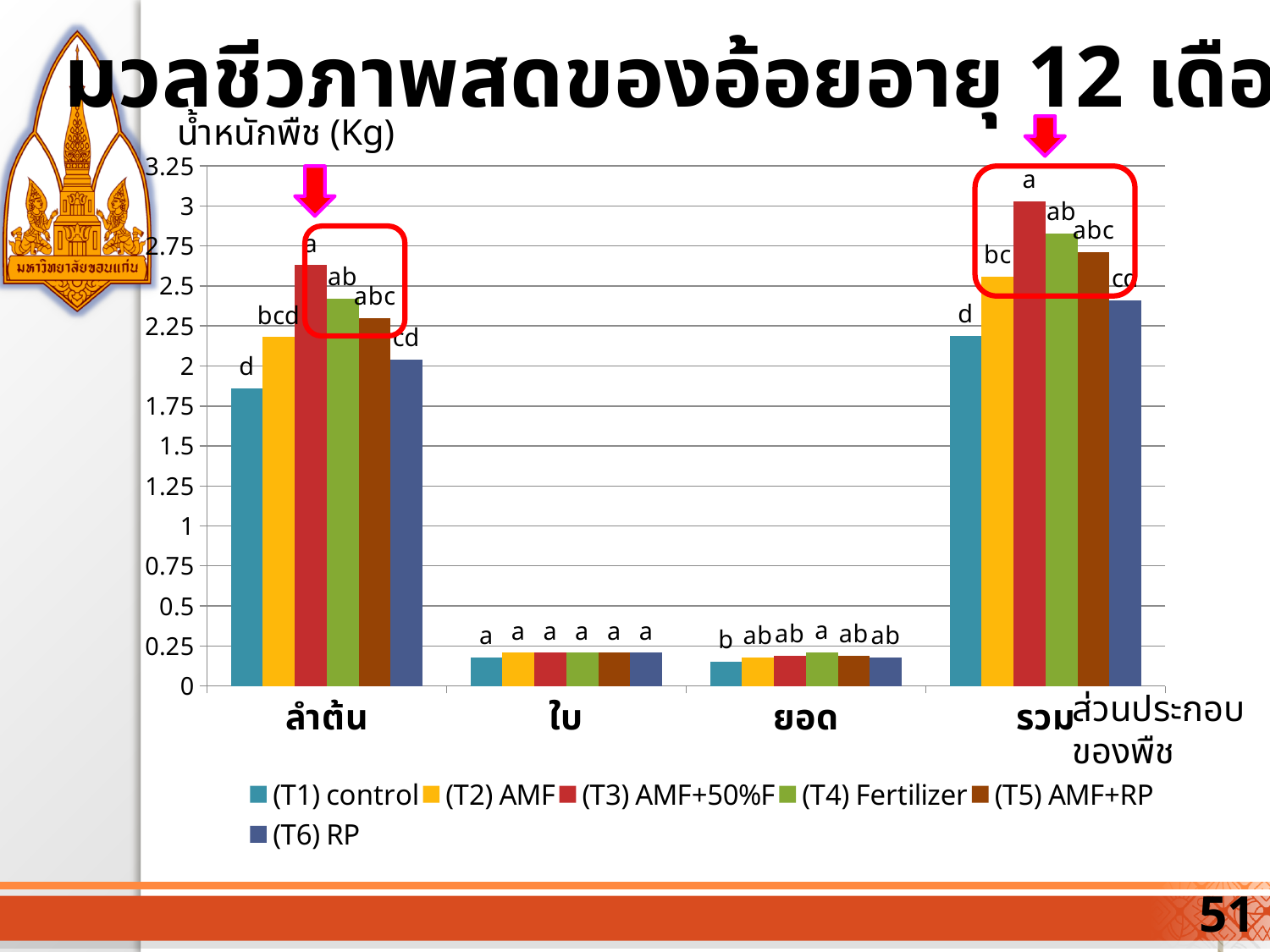
What kind of chart is shown on the slide? bar chart In the รวม category, which is larger: the value for (T3) AMF+50%F or the value for (T6) RP? (T3) AMF+50%F What is the label of the chart's vertical axis? น้ำหนักพืช (Kg) In the ลำต้น category, which series has the highest bar? (T3) AMF+50%F Is the value for (T1) control in the รวม category greater or less than 2.5? less Is the value for (T1) control in the ลำต้น category greater or less than 2? less In the รวม category, which series has the lowest bar? (T1) control Is the value for (T3) AMF+50%F in the ลำต้น category greater or less than 2.5? greater How many categories are shown on the x axis of the chart? 4 How many series does the chart's legend list? 6 In the ลำต้น category, which series has the lowest bar? (T1) control In the รวม category, which series has the highest bar? (T3) AMF+50%F